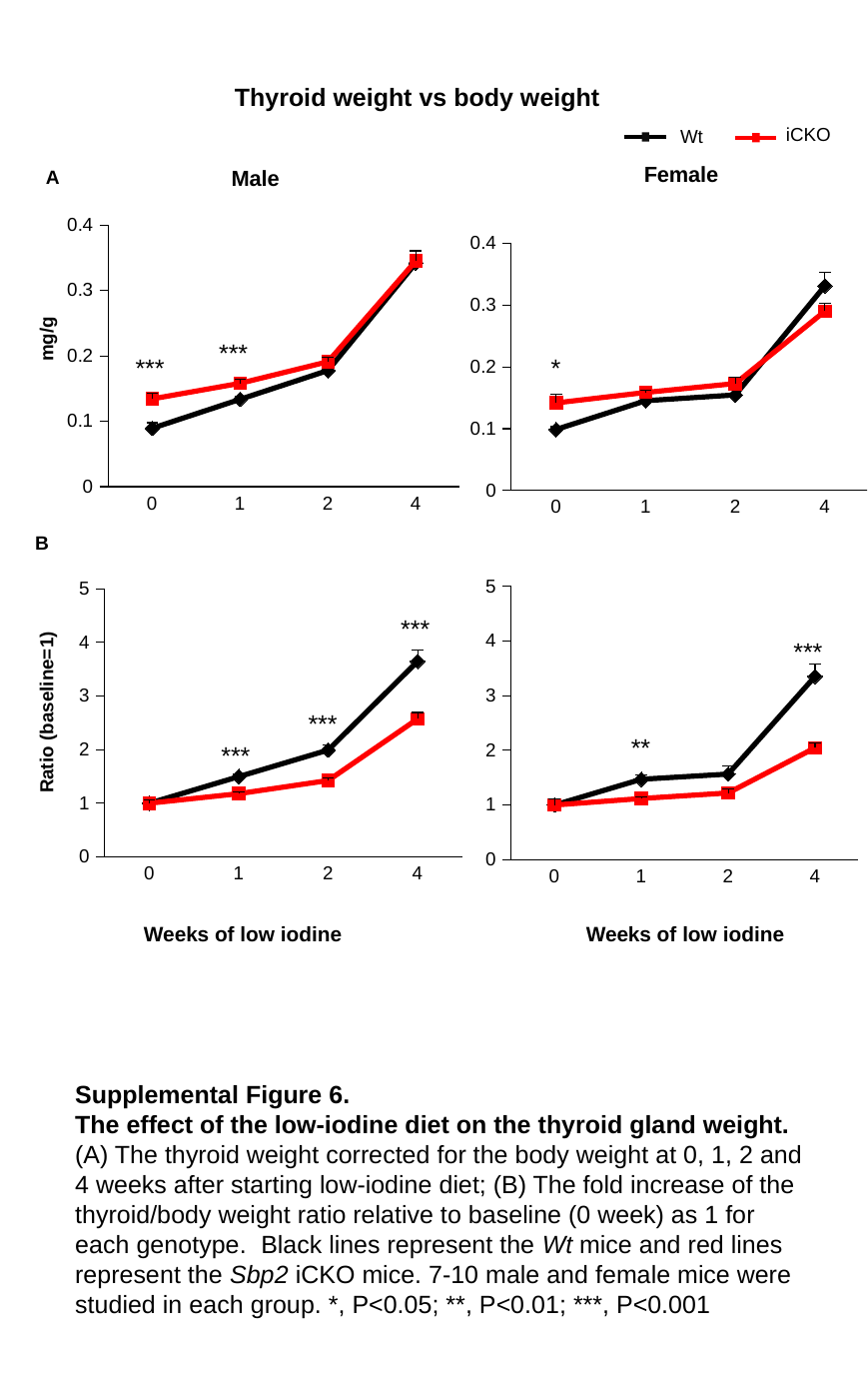
How many series does the legend list? 2 In the Male panel A (top left), which series has the larger value at week 0, Wt or iCKO? iCKO What colour is the iCKO series in the legend? red What is the y-axis label of the panel B charts (bottom row)? Ratio (baseline=1) In the Male panel A (top left), is the iCKO value at week 0 greater or less than 0.1? greater In the Male panel B (bottom left), which series has the larger value at week 4, Wt or iCKO? Wt In the Male panel B (bottom left), how many time points are plotted along the x axis? 4 In the Male panel A (top left), is the Wt value at week 4 greater or less than 0.3? greater In the Male panel A (top left), does the Wt line rise or fall from week 0 to week 4? rise What kind of chart is used in the Male panel A (top left)? line chart In the Female panel B (bottom right), is the iCKO value at week 4 greater or less than 3? less